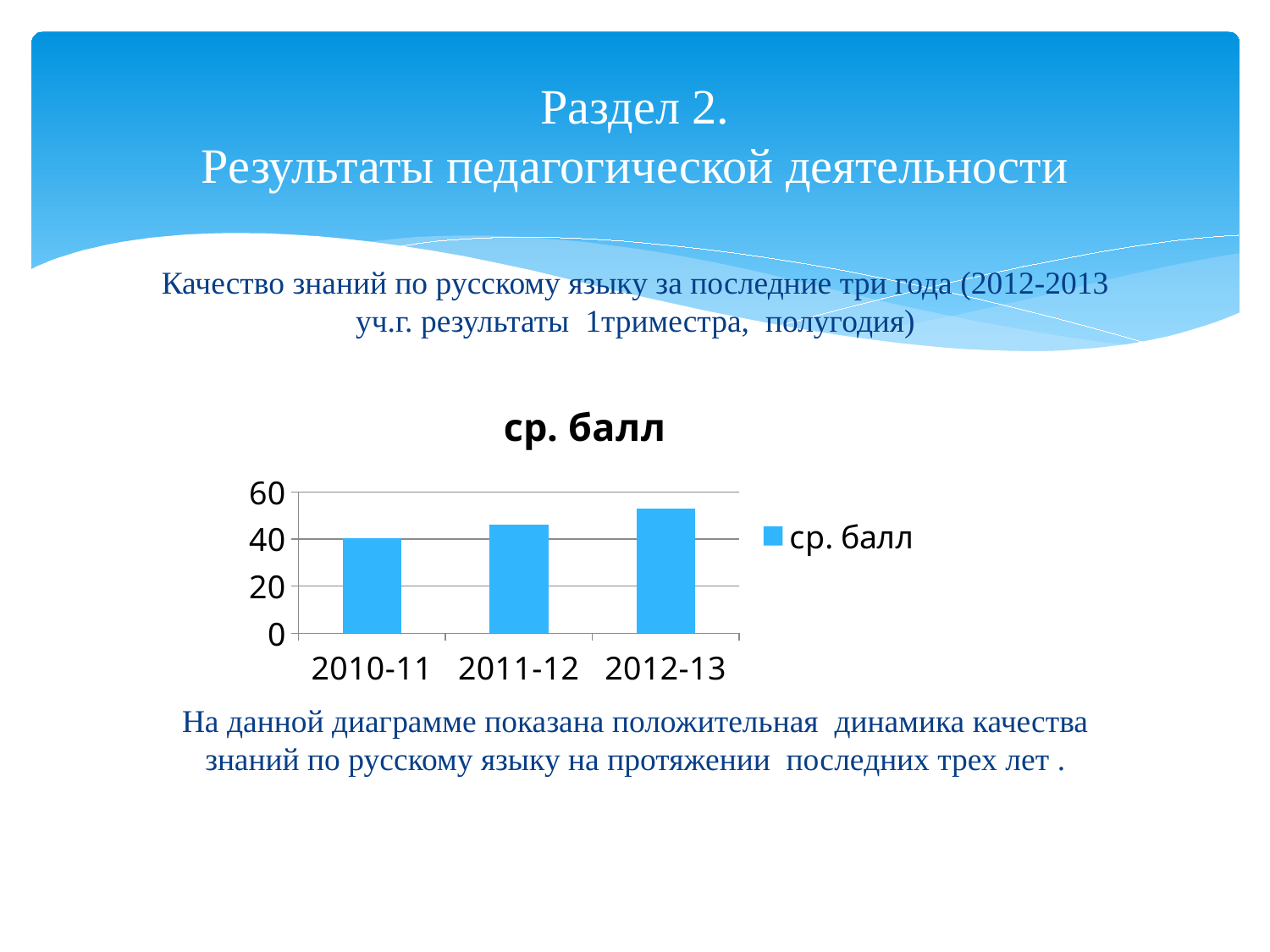
Which year has the lowest value in the chart? 2010-11 How many categories are shown on the x axis of the chart? 3 Is the value for 2012-13 greater or less than 60? less Is the value for 2012-13 greater or less than 40? greater What is the name of the series shown in the chart legend? ср. балл What kind of chart is shown on the slide? bar chart Is the value for 2010-11 greater or less than 20? greater Which year has the highest value in the chart? 2012-13 How many series does the chart legend list? 1 Do the values rise or fall from 2010-11 to 2012-13? rise Which is larger, the value for 2011-12 or the value for 2012-13? 2012-13 What is the title of the chart? ср. балл